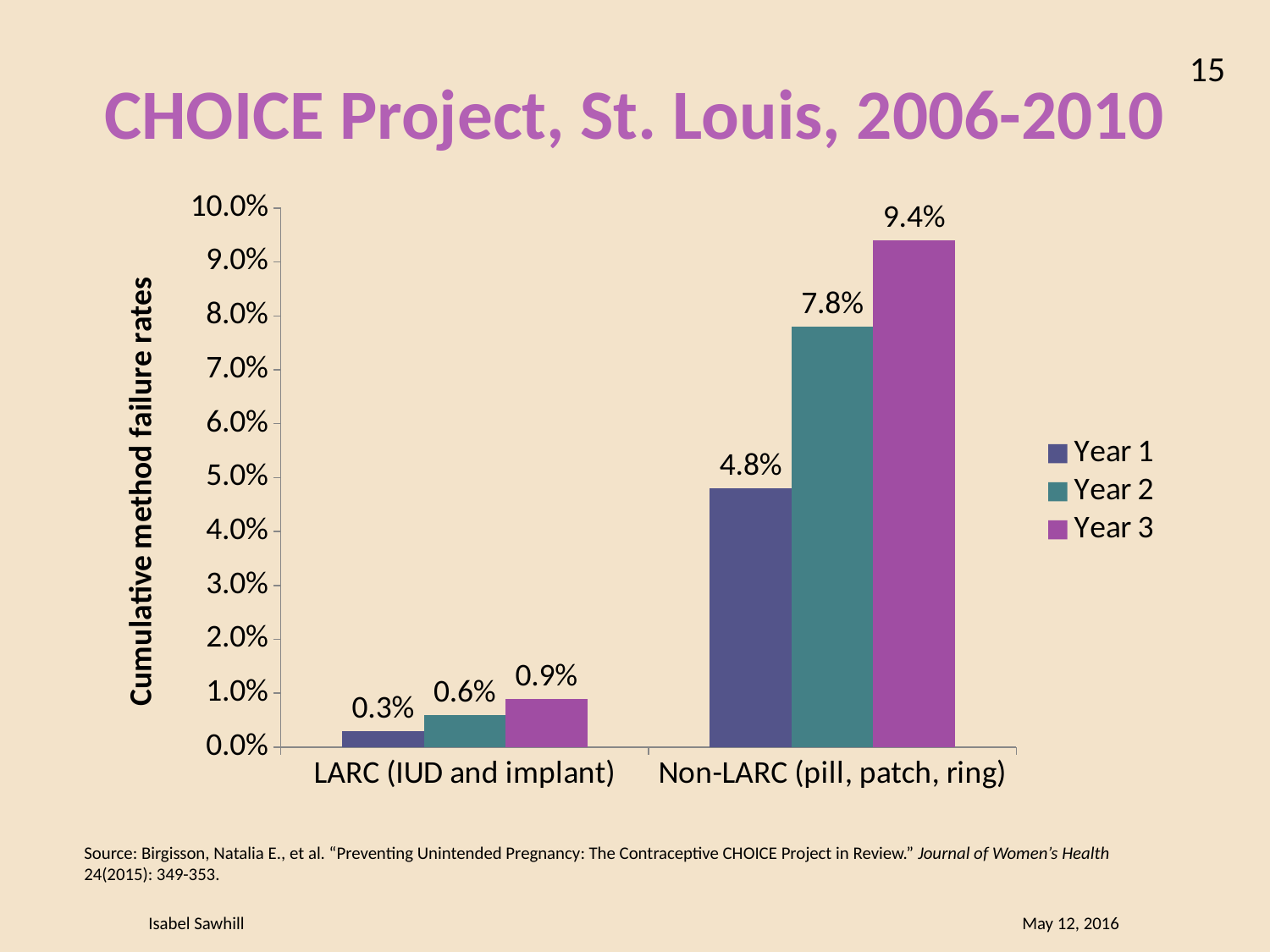
What kind of chart is shown on the slide? Bar chart What is the Year 2 value for Non-LARC (pill, patch, ring)? 7.8% What is the Year 3 cumulative method failure rate for Non-LARC (pill, patch, ring)? 9.4% What is the difference between the Year 3 failure rates for Non-LARC and LARC? 8.5% What is the difference between the Year 3 and Year 1 failure rates for Non-LARC (pill, patch, ring)? 4.6% What is the Year 1 cumulative method failure rate for LARC (IUD and implant)? 0.3% Which bar shows the lowest cumulative method failure rate on the chart? Year 1, LARC (IUD and implant) Which bar shows the highest cumulative method failure rate on the chart? Year 3, Non-LARC (pill, patch, ring) Do the failure rates for Non-LARC (pill, patch, ring) rise or fall from Year 1 to Year 3? Rise Which is larger, the Year 2 value for LARC (IUD and implant) or the Year 1 value for Non-LARC (pill, patch, ring)? Year 1 value for Non-LARC (pill, patch, ring) How many series does the legend list? 3 How many categories are shown on the x axis? 2